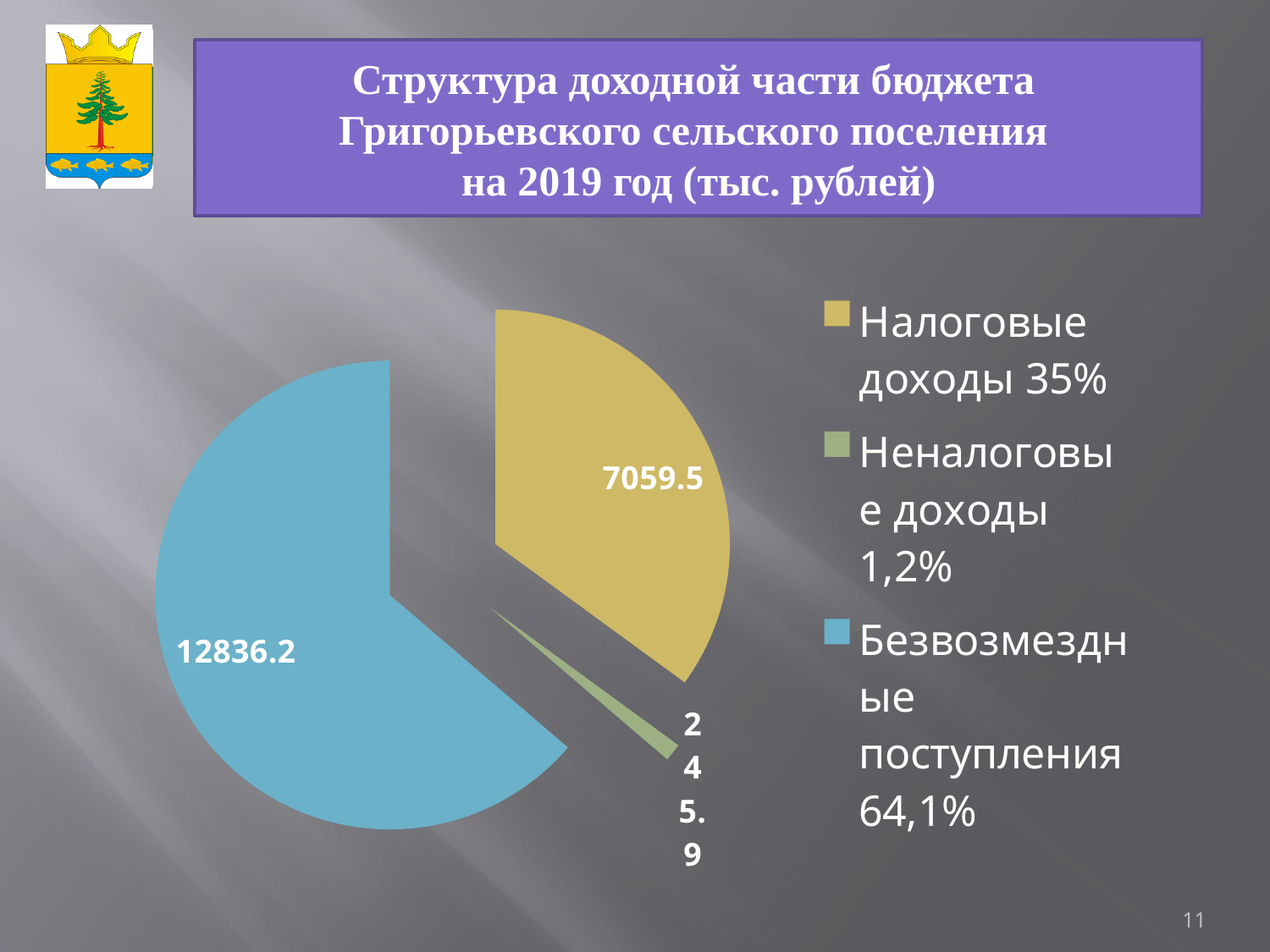
What is the difference between the value for Безвозмездные поступления and the value for Налоговые доходы? 5776.7 Which is larger, the value for Налоговые доходы or the value for Безвозмездные поступления? Безвозмездные поступления Which category has the largest slice of the pie? Безвозмездные поступления Which category has the smallest slice of the pie? Неналоговые доходы What kind of chart is shown on the slide? Pie chart What is the value shown for Неналоговые доходы? 245.9 What share of the pie do Безвозмездные поступления make up, according to the legend? 64,1% What colour is the slice for Налоговые доходы? Yellow What share of the pie do Налоговые доходы make up, according to the legend? 35% What is the value shown for Налоговые доходы? 7059.5 How many slices does the pie chart have? 3 What is the value shown for Безвозмездные поступления? 12836.2